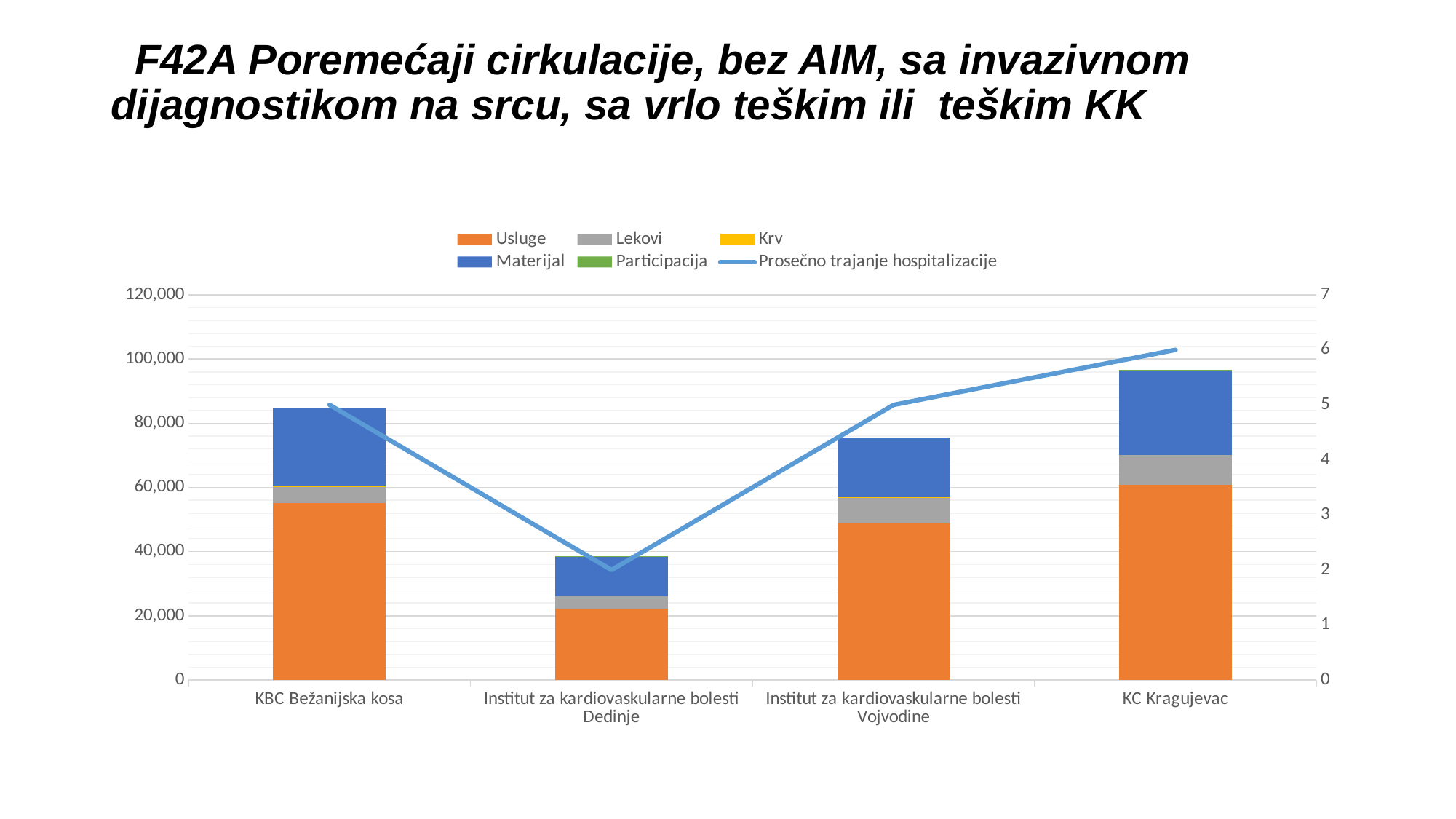
For which institution is the Prosečno trajanje hospitalizacije line at its lowest point? Institut za kardiovaskularne bolesti Dedinje Is the total stacked bar for KBC Bežanijska kosa greater or less than 80,000? greater Which has the taller stacked bar, KBC Bežanijska kosa or Institut za kardiovaskularne bolesti Vojvodine? KBC Bežanijska kosa How many institutions (categories) are shown on the x axis? 4 Which institution has the tallest stacked bar? KC Kragujevac Is the Prosečno trajanje hospitalizacije value for KC Kragujevac greater or less than 5? greater Which institution has the shortest stacked bar? Institut za kardiovaskularne bolesti Dedinje What kind of chart is shown on the slide? combination bar and line chart Is the total stacked bar for Institut za kardiovaskularne bolesti Vojvodine greater or less than 60,000? greater How many series does the legend list? 6 Which series is plotted as a line rather than as bars? Prosečno trajanje hospitalizacije